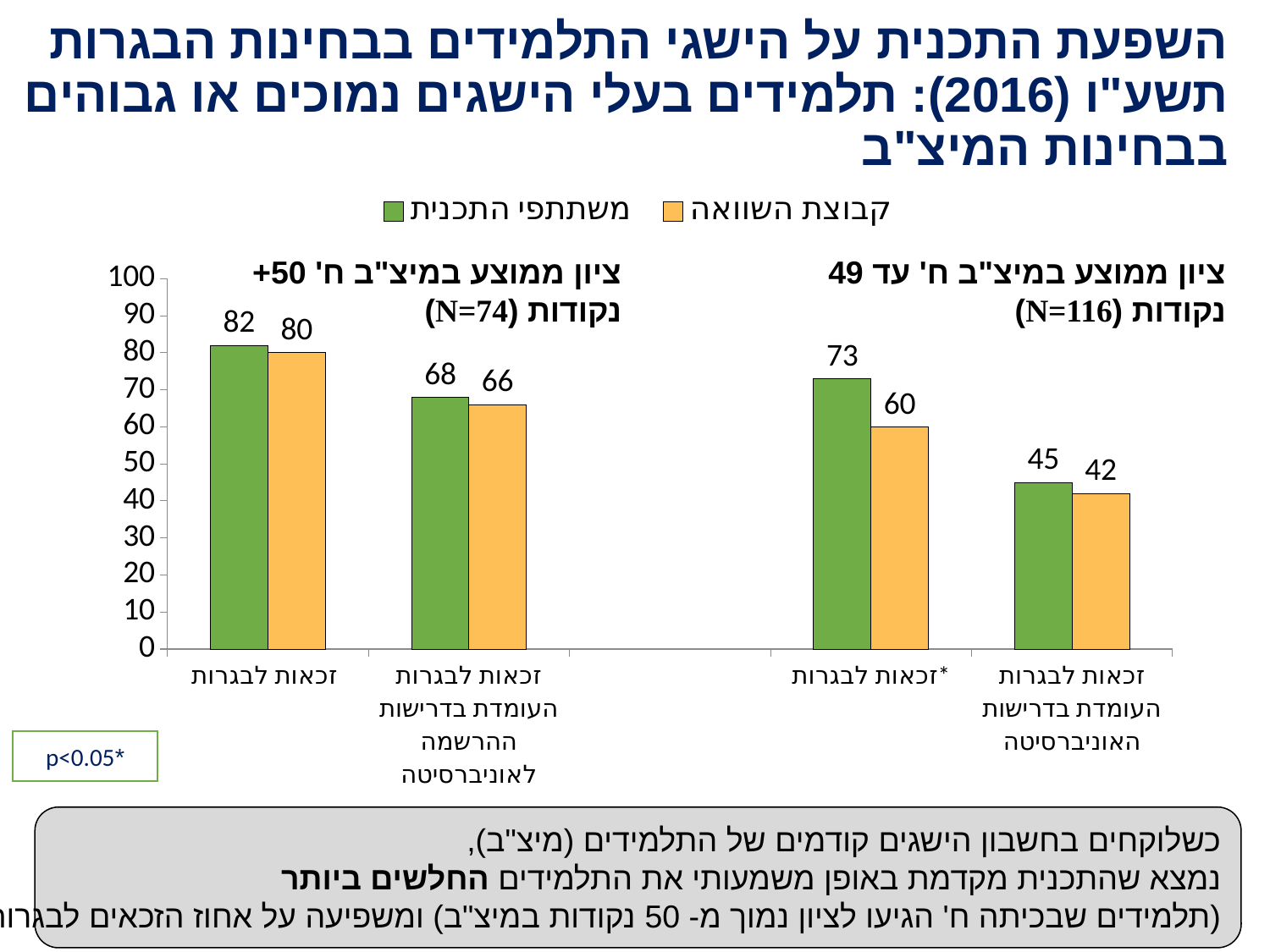
What kind of chart is shown on the slide? Bar chart What is the value for קבוצת השוואה for זכאות לבגרות in the group ציון ממוצע במיצ"ב ח' עד 49 נקודות (N=116)? 60 Which colour represents קבוצת השוואה in the legend? Orange Which bar has the highest value on the chart? משתתפי התכנית, זכאות לבגרות (50+ נקודות group) What is the value for משתתפי התכנית for זכאות לבגרות in the group ציון ממוצע במיצ"ב ח' עד 49 נקודות (N=116)? 73 In the group ציון ממוצע במיצ"ב ח' עד 49 נקודות (N=116), which is larger for זכאות לבגרות: משתתפי התכנית or קבוצת השוואה? משתתפי התכנית How many series does the legend list? 2 Which bar has the lowest value on the chart? קבוצת השוואה, זכאות לבגרות העומדת בדרישות האוניברסיטה (עד 49 נקודות group) What is the value for קבוצת השוואה for זכאות לבגרות העומדת בדרישות ההרשמה לאוניברסיטה in the group ציון ממוצע במיצ"ב ח' 50+ נקודות (N=74)? 66 What is the difference between משתתפי התכנית and קבוצת השוואה for זכאות לבגרות העומדת בדרישות האוניברסיטה in the group ציון ממוצע במיצ"ב ח' עד 49 נקודות (N=116)? 3 What is the value for משתתפי התכנית for זכאות לבגרות in the group ציון ממוצע במיצ"ב ח' 50+ נקודות (N=74)? 82 What is the difference between משתתפי התכנית and קבוצת השוואה for זכאות לבגרות in the group ציון ממוצע במיצ"ב ח' עד 49 נקודות (N=116)? 13